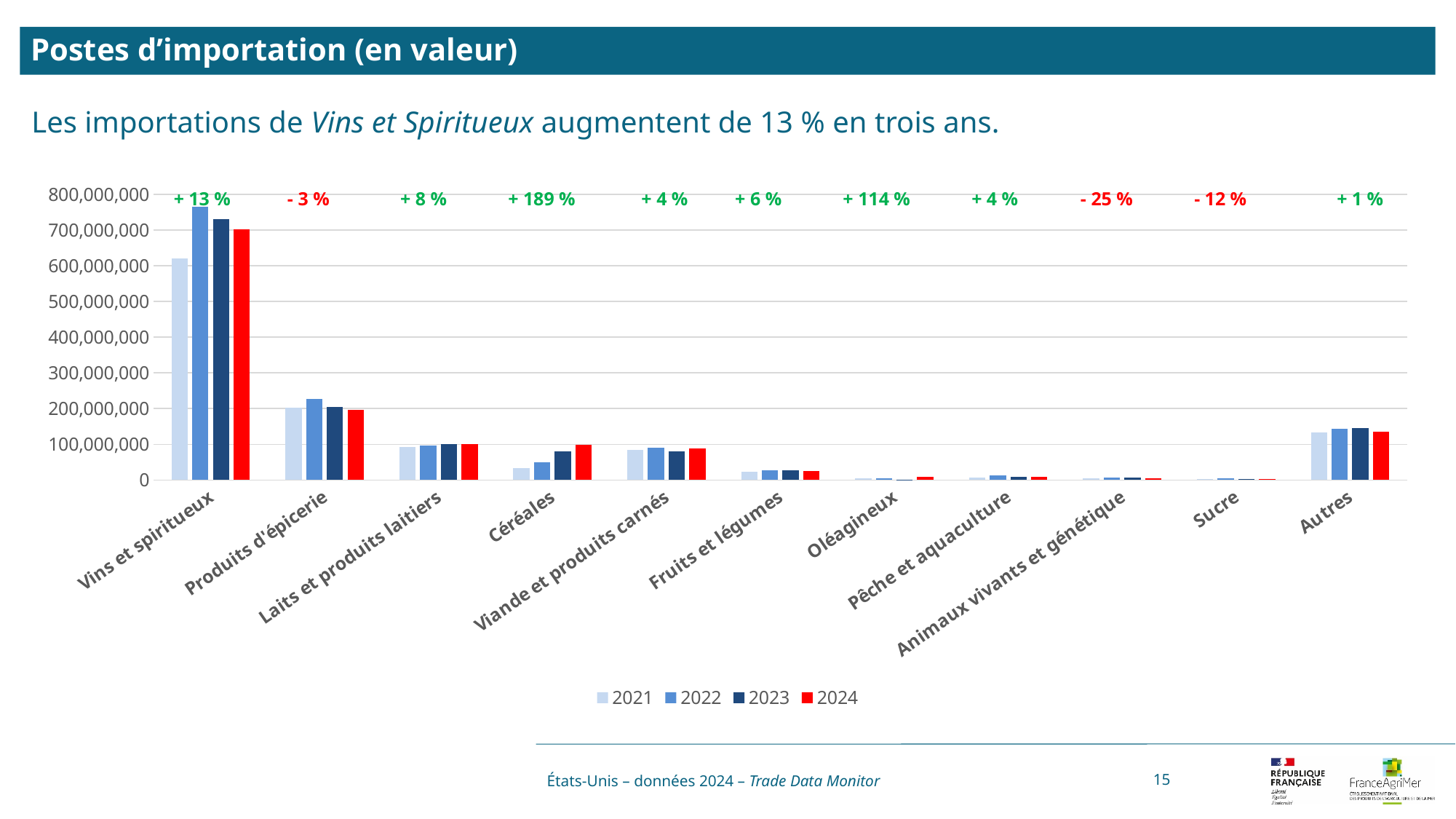
What kind of chart is shown on the slide? bar chart Is the 2022 value for Vins et spiritueux greater or less than 700,000,000? greater Which category has the lowest printed percentage change? Animaux vivants et génétique Do the values for Céréales rise or fall from 2021 to 2024? rise For Céréales, which is larger: the 2021 value or the 2024 value? 2024 What percentage change is printed above the Animaux vivants et génétique category? - 25 % How many categories are shown on the x axis? 11 Is the 2022 value for Produits d'épicerie greater or less than 200,000,000? greater How many series does the legend list? 4 What percentage change is printed above the Oléagineux category? + 114 % What percentage change is printed above the Céréales category? + 189 % Which category has the highest 2024 value? Vins et spiritueux